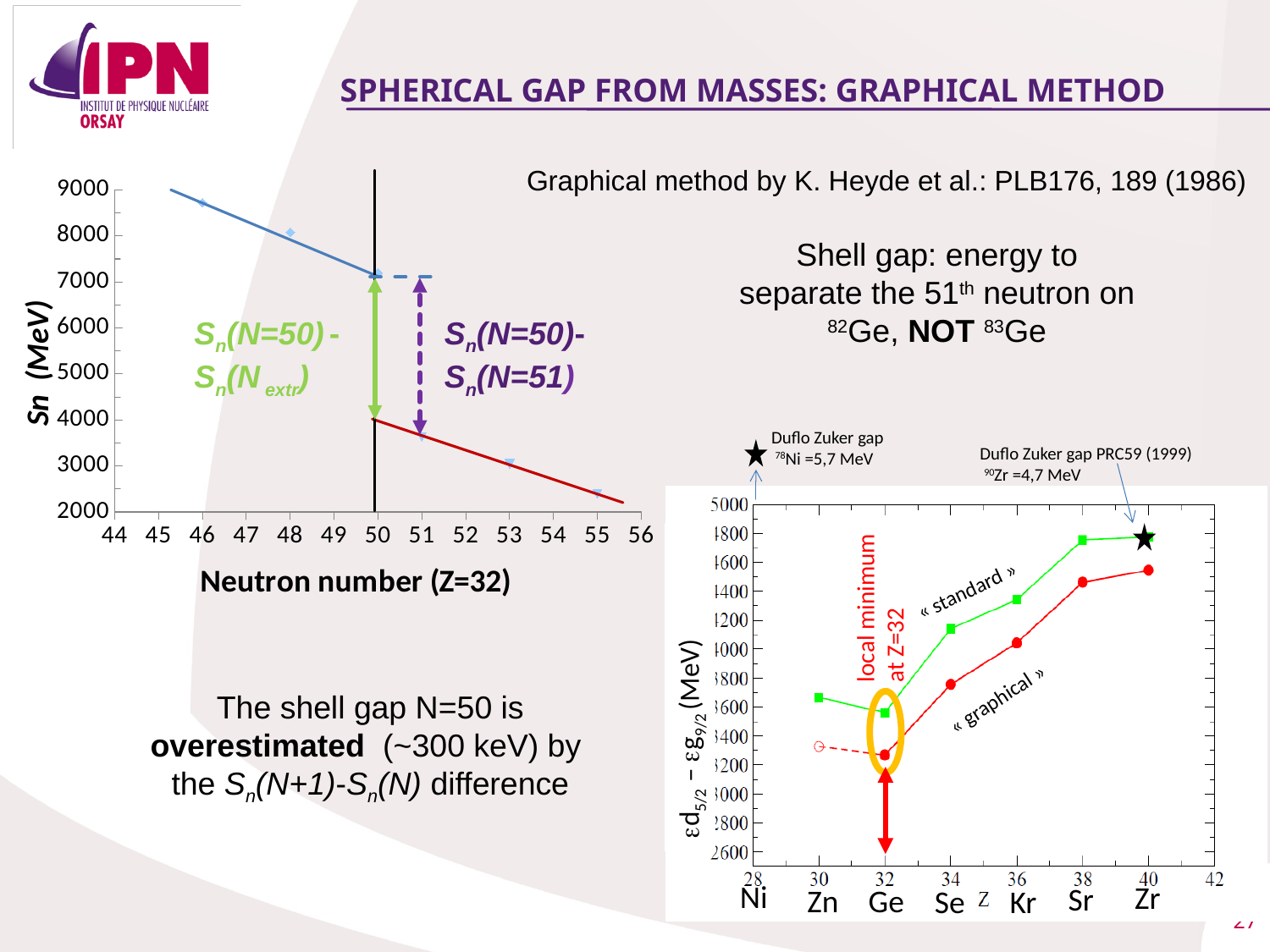
In the right chart, is the « standard » (green) value at Z=34 greater or less than 4000? greater In the right chart, do the « graphical » (red) values rise or fall from Z=32 to Z=40? rise In the left chart, is the Sn value at neutron number 51 greater or less than 4000? less What kind of chart is the left chart of Sn versus neutron number? line chart In the left chart, is the Sn value at neutron number 46 greater or less than 8000? greater In the right chart, at Z=36 (Kr), which curve has the larger value, « standard » or « graphical »? « standard » In the right chart, what are the two curves labelled? « standard » and « graphical » In the left chart, which has the larger Sn value, neutron number 48 or neutron number 53? neutron number 48 In the left chart, what is the x-axis title? Neutron number (Z=32) In the right chart of εd5/2 − εg9/2 versus Z, how many curves are plotted? 2 In the left chart, do the Sn values rise or fall as the neutron number increases? fall